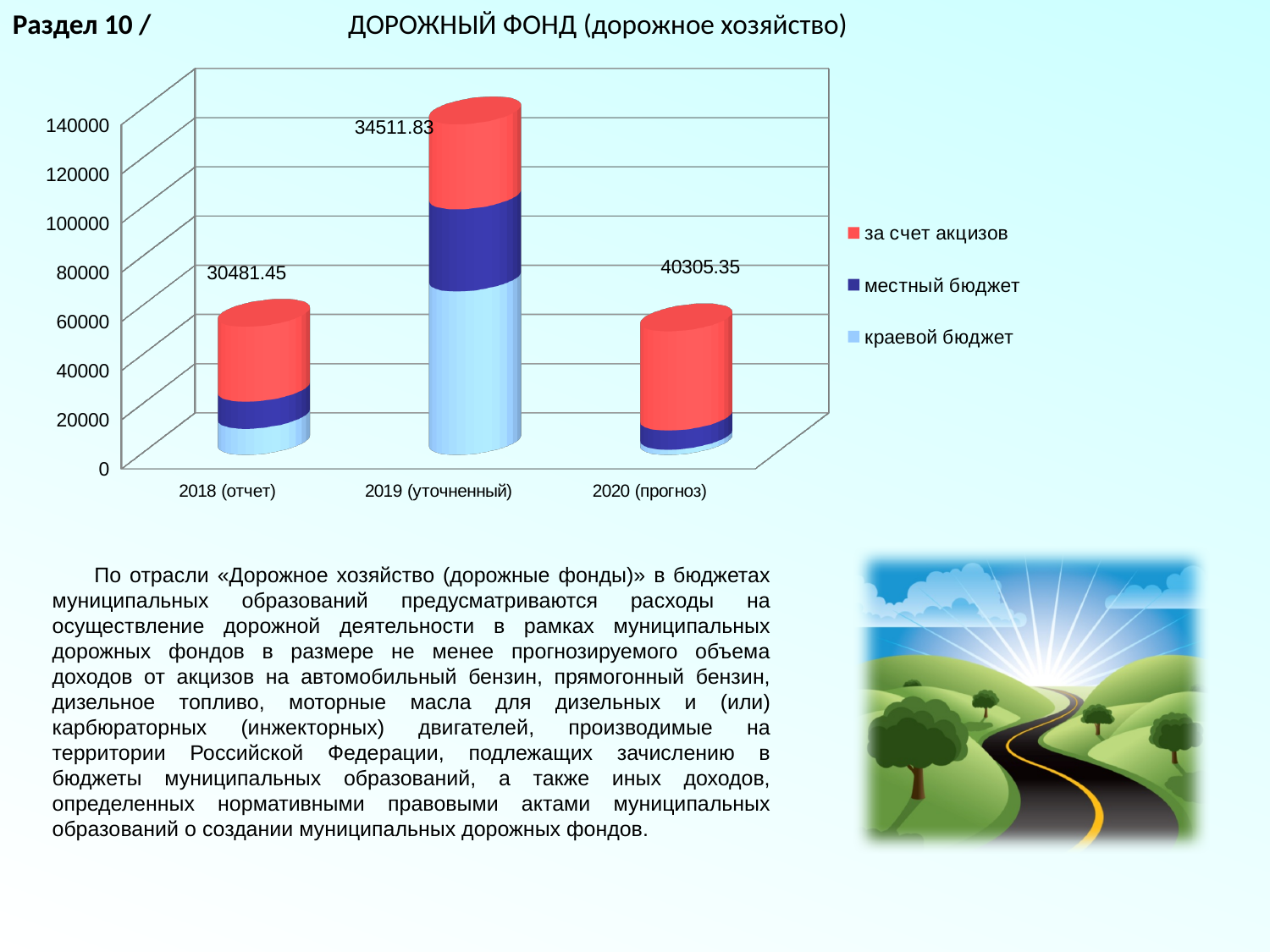
What is the value labelled for 'за счет акцизов' in 2018 (отчет)? 30481.45 Which is larger, the 'за счет акцизов' value for 2019 (уточненный) or for 2020 (прогноз)? 2020 (прогноз) In which year is the labelled 'за счет акцизов' value the lowest? 2018 (отчет) What is the value labelled for 'за счет акцизов' in 2020 (прогноз)? 40305.35 Do the labelled 'за счет акцизов' values rise or fall from 2018 to 2020? rise Is the total height of the 2019 (уточненный) bar greater or less than 100000? greater What is the difference between the 'за счет акцизов' values for 2020 (прогноз) and 2018 (отчет)? 9823.90 In which year is the labelled 'за счет акцизов' value the highest? 2020 (прогноз) Is the total height of the 2018 (отчет) bar greater or less than 80000? less How many categories (years) are shown on the x axis? 3 What is the value labelled for 'за счет акцизов' in 2019 (уточненный)? 34511.83 How many series does the legend list? 3